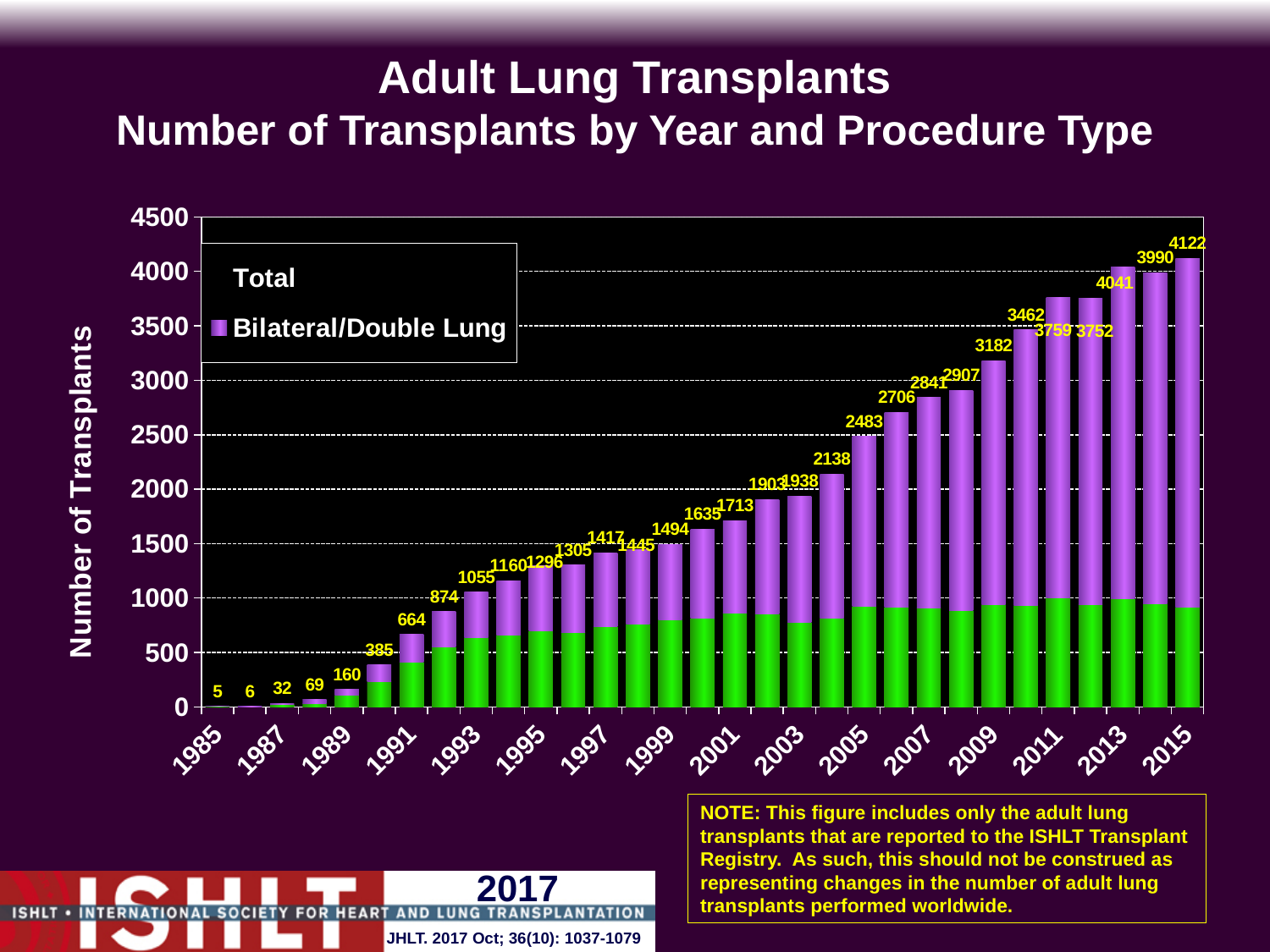
What is the total number of transplants labelled for 1990? 385 What is the total number of adult lung transplants shown for 2015? 4122 What is the title of the vertical axis? Number of Transplants What is the difference between the total for 2010 and the total for 2009? 280 Which year has the larger total, 2013 or 2014? 2013 How many years (bars) are plotted on the chart? 31 What is the difference between the total for 2015 and the total for 2014? 132 Which year has the lowest total number of transplants? 1985 What is the total number of transplants labelled for 2005? 2483 Which year has the highest total number of transplants? 2015 What kind of chart is shown on the slide? Stacked bar chart Do the total numbers of transplants generally rise or fall from 1985 to 2015? Rise